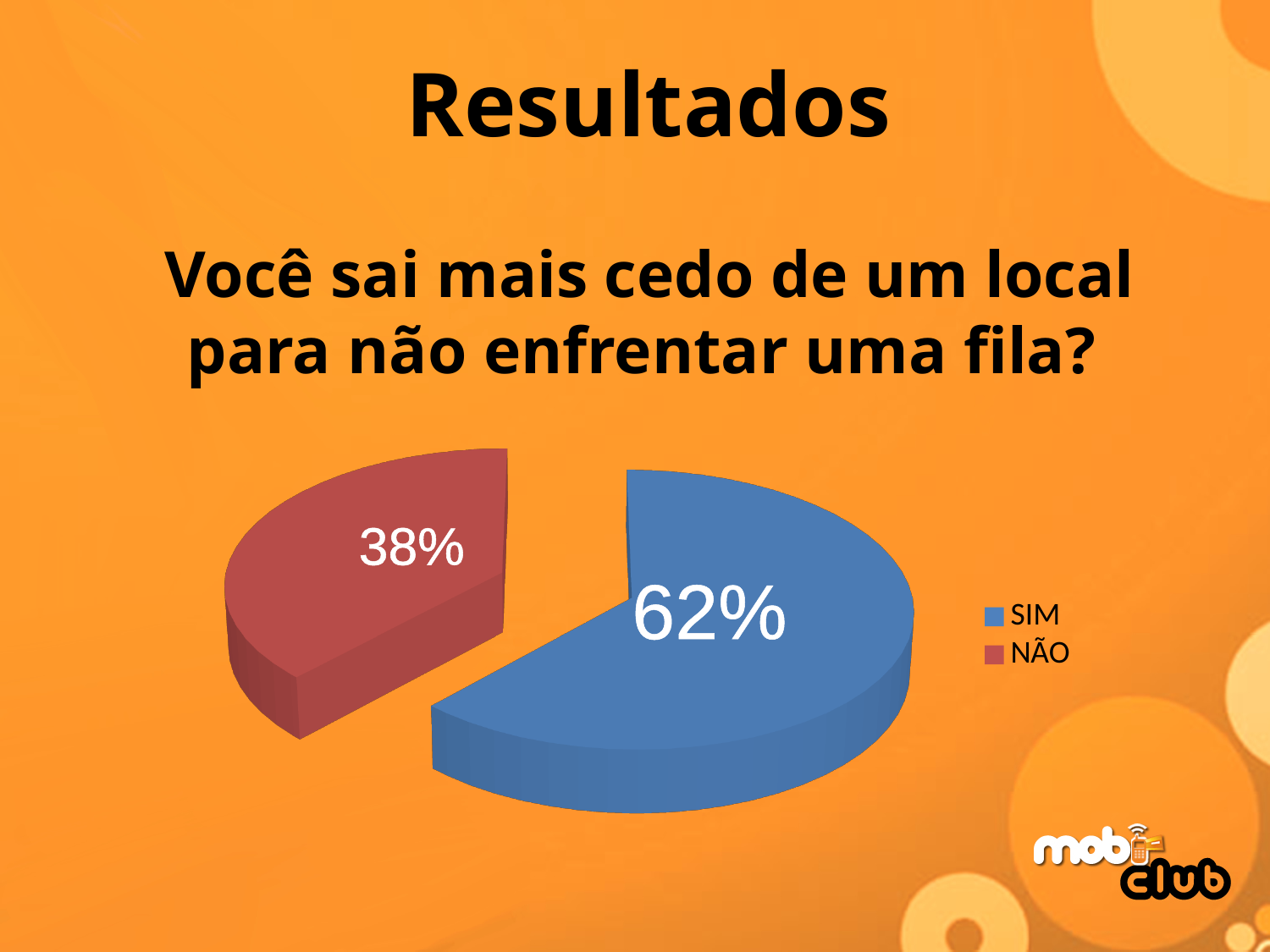
How many slices does the pie chart have? 2 What colour is the slice for NÃO? Red What share of the pie does the SIM slice represent? 62% Which response has the smallest share of the pie? NÃO What question is the chart answering? Você sai mais cedo de um local para não enfrentar uma fila? Which is larger, the share for SIM or the share for NÃO? SIM What is the difference in percentage points between SIM and NÃO? 24 How many entries does the legend list? 2 What kind of chart is shown on the slide? Pie chart What percentage of respondents answered SIM? 62% What percentage of respondents answered NÃO? 38% Which response has the largest share of the pie? SIM